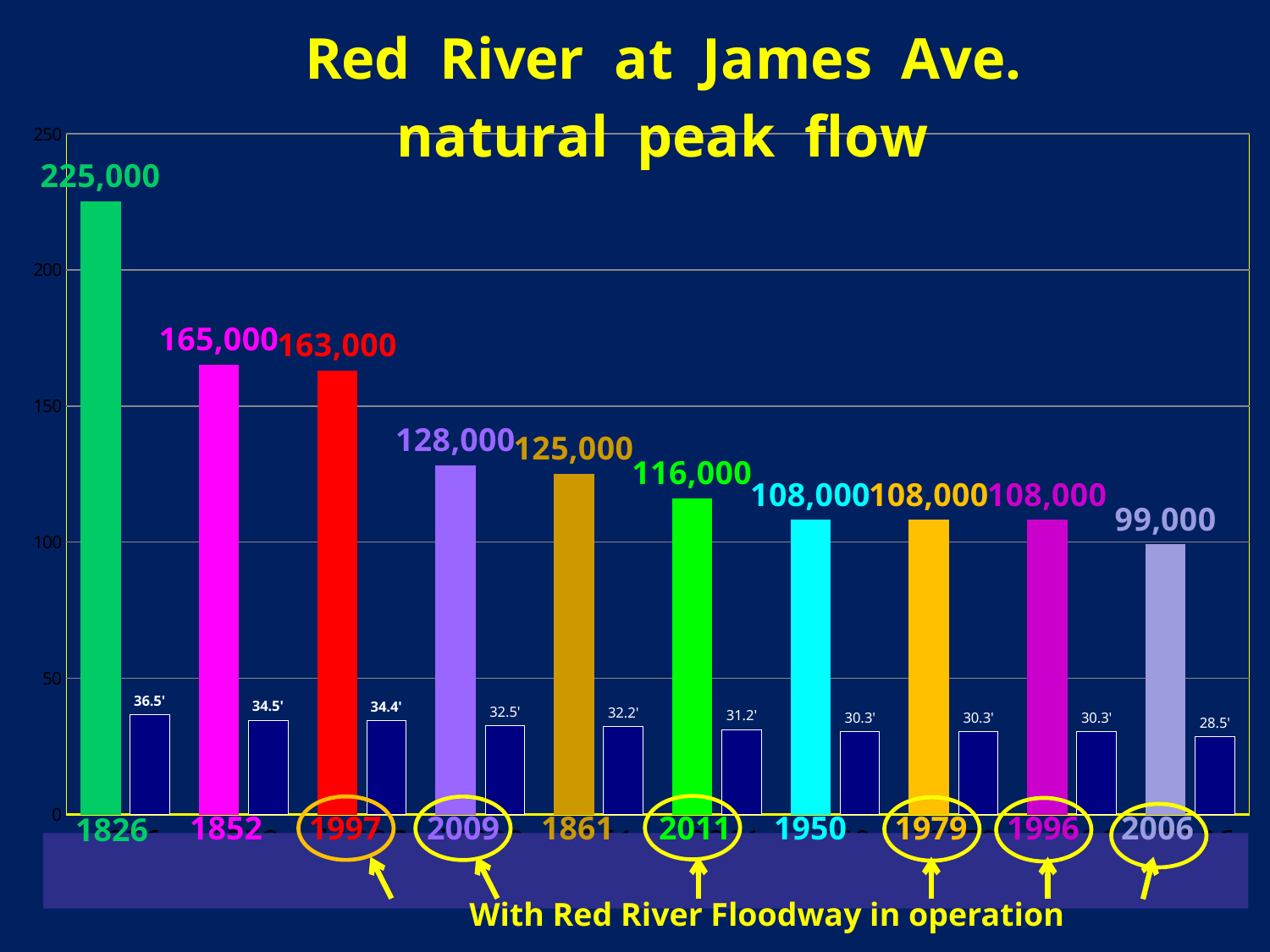
What is the natural peak flow value shown for 2009? 128,000 What is the difference between the natural peak flow for 1826 and for 1852? 60,000 Which year has the lowest natural peak flow? 2006 What kind of chart is shown on the slide? bar chart What is the difference between the natural peak flow for 2009 and for 1861? 3,000 What is the natural peak flow value shown for 1826? 225,000 How many years are shown on the x axis? 10 What is the small dark-blue bar label shown for 1997? 34.4' Which year has the highest natural peak flow? 1826 What is the natural peak flow value shown for 2006? 99,000 What is the title of the chart? Red River at James Ave. natural peak flow Which has a larger natural peak flow, 1852 or 2011? 1852